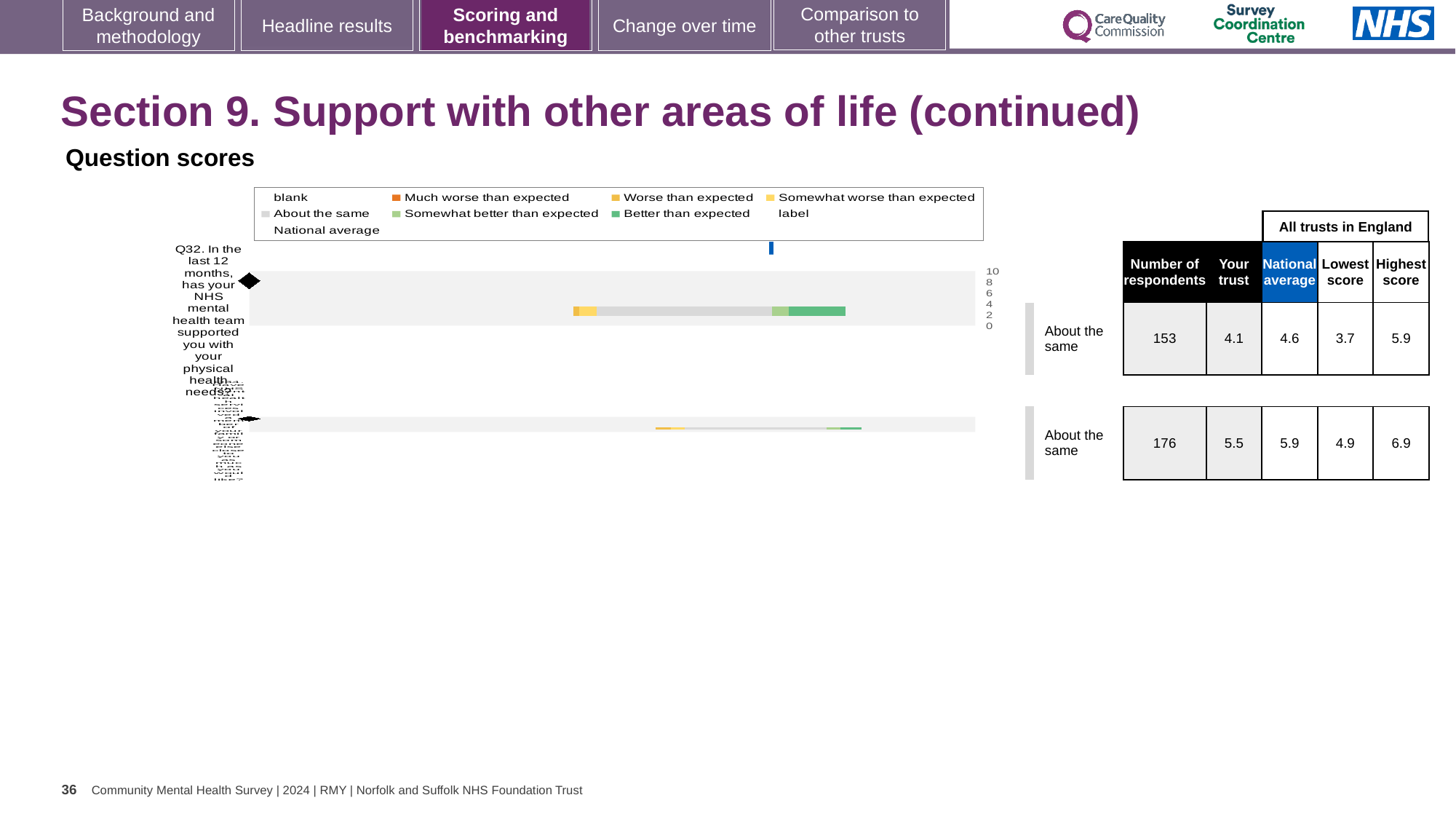
What is the lowest score among all trusts in England for Q32? 3.7 What is the highest score among all trusts in England for Q32? 5.9 Which benchmark category is Q32 placed in? About the same How many questions are plotted on the chart? 2 For Q32, which is larger: the trust's score or the national average? National average For Q32, what is the difference between the highest score and the lowest score across all trusts in England? 2.2 For Q32, how much higher is the national average than the trust's score? 0.5 What is the national average score for Q32? 4.6 What kind of chart is used to show the question scores? Bar chart What is the 'Your trust' score for Q32 (support with physical health needs)? 4.1 How many respondents answered Q32? 153 What colour represents 'Much worse than expected' in the legend? Orange